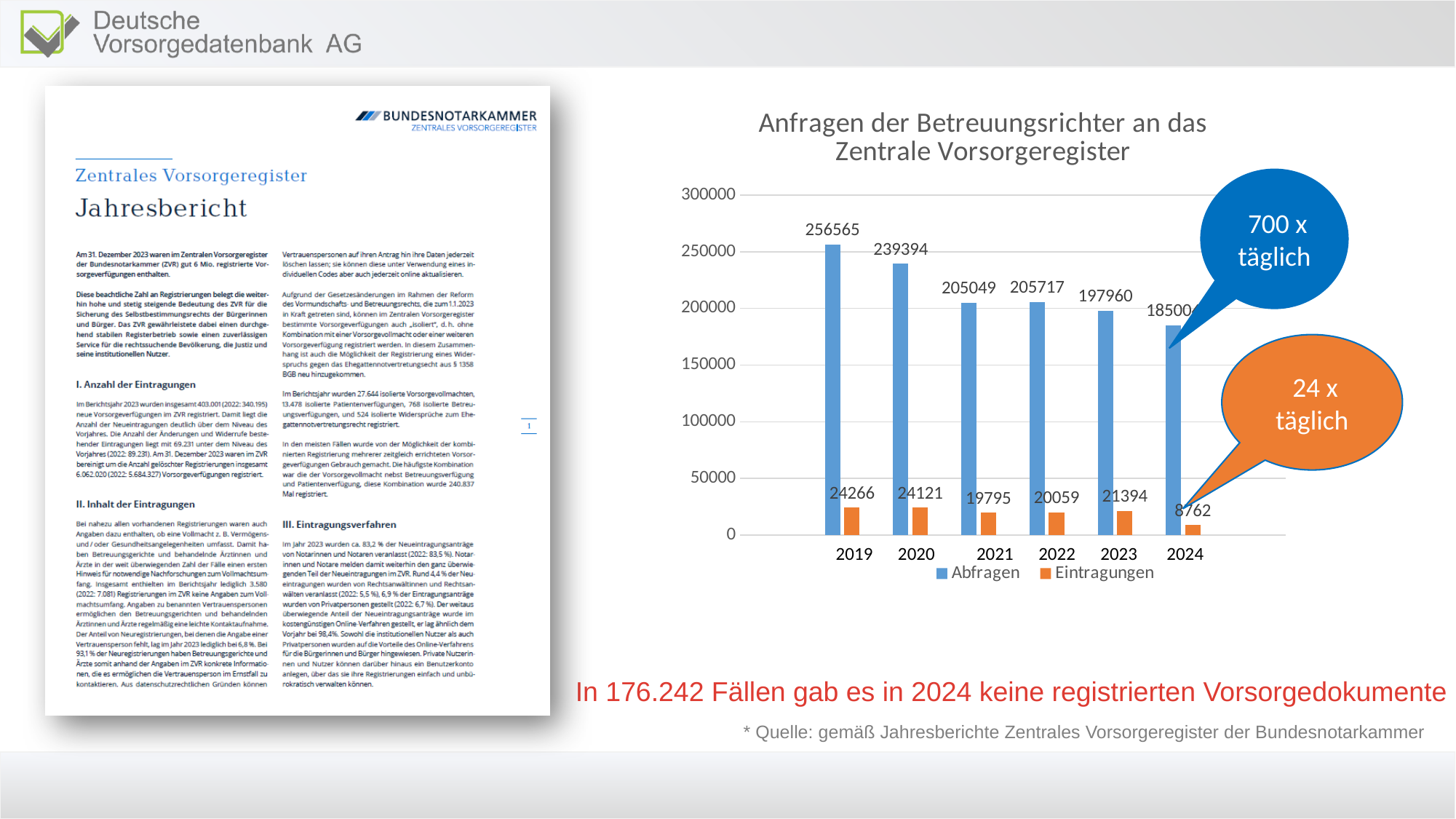
What is the value for Eintragungen in 2024? 8762 What is the difference between Eintragungen in 2023 and Eintragungen in 2024? 12632 What is the difference between Abfragen and Eintragungen in 2019? 232299 Which is larger: Abfragen in 2021 or Abfragen in 2022? Abfragen in 2022 How many series does the legend list? 2 Is the value for Abfragen in 2024 greater or less than 200000? less How many years are shown on the x axis? 6 What kind of chart is shown? bar chart What is the value for Abfragen in 2022? 205717 What is the value for Abfragen in 2019? 256565 Which year has the lowest value for Eintragungen? 2024 Which year has the highest value for Abfragen? 2019